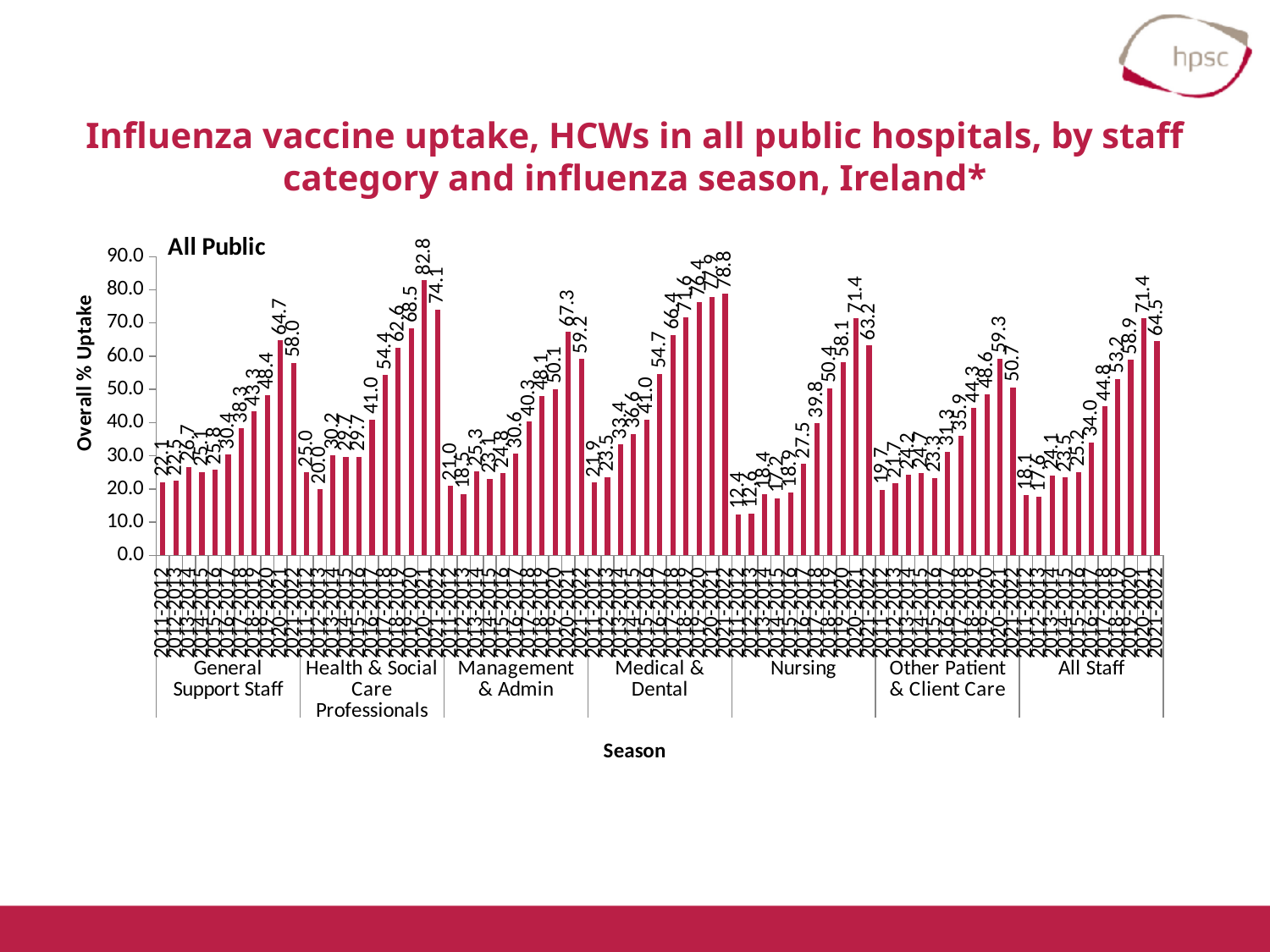
What is the value for Medical & Dental in the last season shown (2021-2022)? 78.8 What is the value for Health & Social Care Professionals in the last season shown (2021-2022)? 74.1 What is the label on the y axis of the chart? Overall % Uptake What is the difference between the Health & Social Care Professionals values for 2020-2021 (82.8) and 2021-2022 (74.1)? 8.7 How many staff categories are shown along the x axis of the chart? 7 What is the value for All Staff in the last season shown (2021-2022)? 64.5 Is the value for Nursing in 2020-2021 greater or less than 70? greater What type of chart is shown on the slide? bar chart Within each staff category, do the values generally rise or fall from the first season to 2020-2021? rise What is the highest value shown in the chart, and for which staff category? 82.8, Health & Social Care Professionals Which staff category has the lowest bar in the chart? Nursing In the last season shown (2021-2022), which is larger: the value for Medical & Dental or the value for Nursing? Medical & Dental